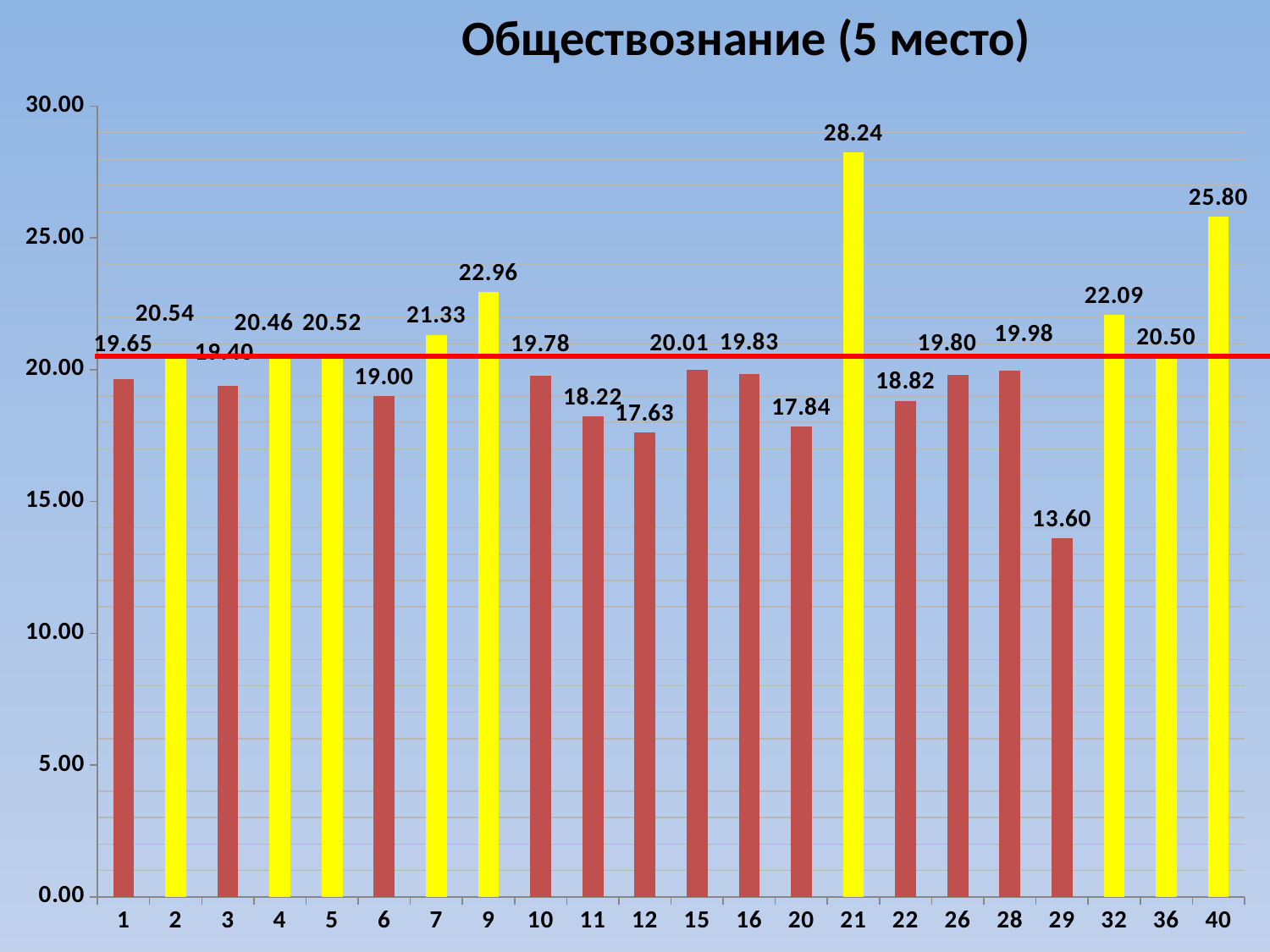
What is the value for category 29? 13.60 What is the difference between the values for category 9 and category 29? 9.36 What is the value for category 12? 17.63 What is the title of the chart? Обществознание (5 место) Is the value for category 40 greater or less than 25.00? greater Which has a larger value, category 9 or category 32? 9 What is the difference between the values for category 21 and category 40? 2.44 Which category has the lowest value? 29 What kind of chart is shown on the slide? bar chart What is the value for category 21? 28.24 Which category has the highest value? 21 How many categories are shown on the x axis? 22